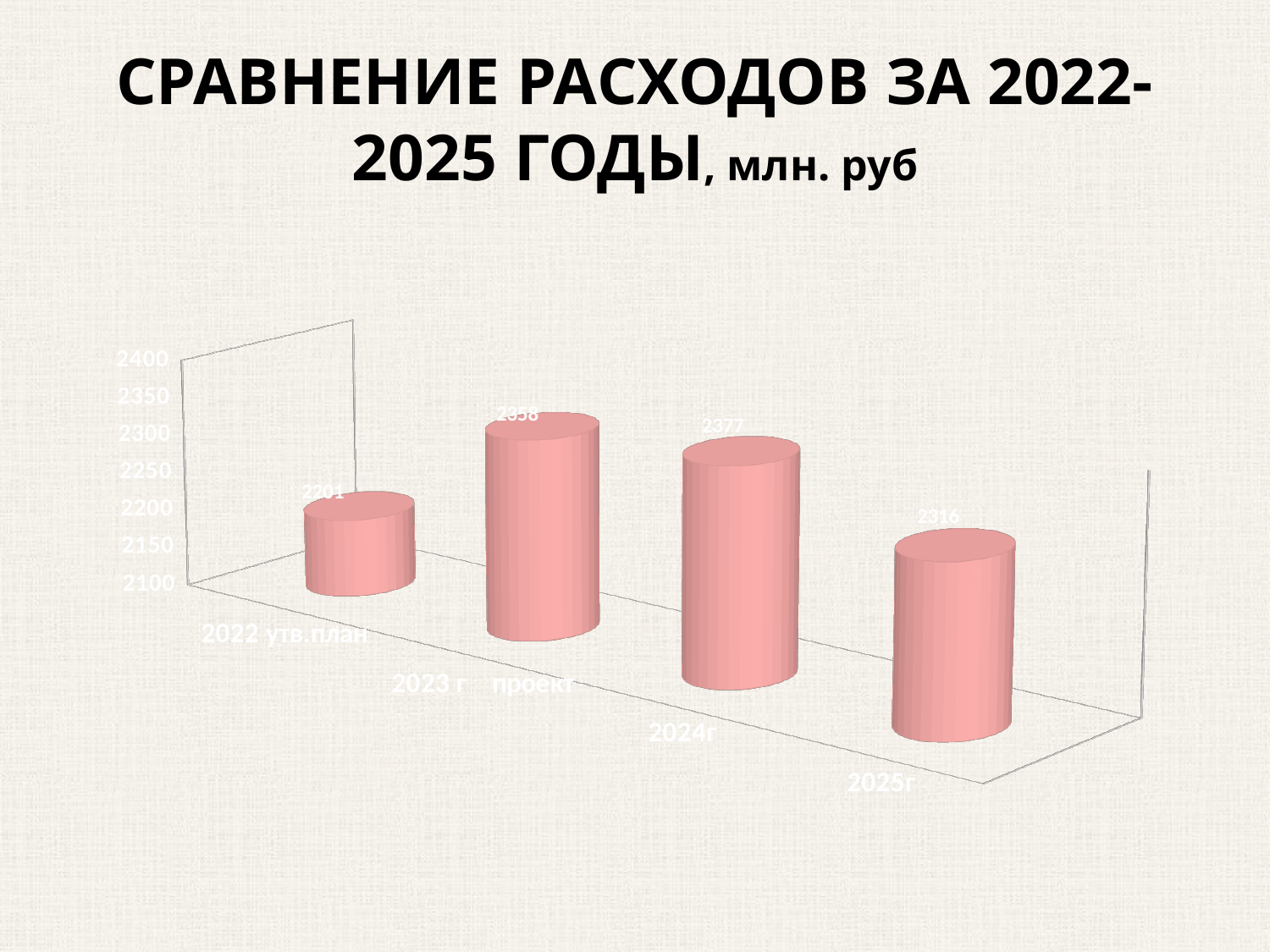
What is the value for 2023 г проект? 2358 What is the difference between the values for 2024г and 2022 утв.план? 176 Which category has the highest value? 2024г Which category has the lowest value? 2022 утв.план What kind of chart is shown on the slide? bar chart What is the value for 2024г? 2377 What unit is given in the chart title? млн. руб Which is larger, the value for 2023 г проект or the value for 2025г? 2023 г проект How many categories are shown on the chart? 4 What is the value for 2022 утв.план? 2201 What is the value for 2025г? 2316 Is the value for 2025г greater or less than 2300? greater